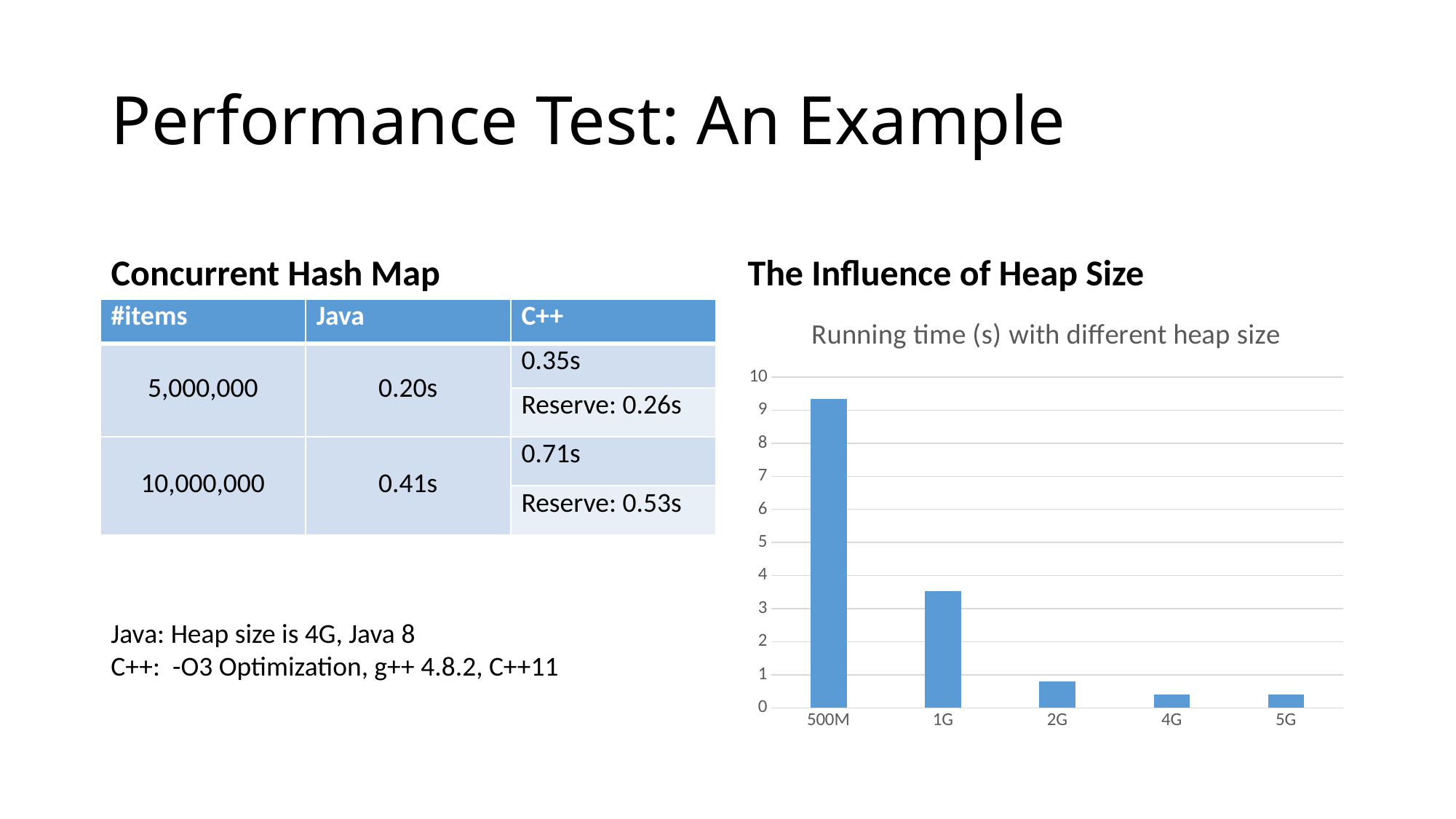
Which heap size has the highest running time in the chart? 500M Is the running time for 1G greater or less than 4? less Is the running time for 2G greater or less than 1? less Does the running time rise or fall as heap size increases from 500M to 5G? fall Is the running time for 4G greater or less than 1? less Which has a larger running time, 500M or 1G? 500M Which has a larger running time, 1G or 2G? 1G What is the title of the chart on the right side of the slide? Running time (s) with different heap size What kind of chart is shown under "The Influence of Heap Size"? bar chart How many heap size categories are plotted in the chart? 5